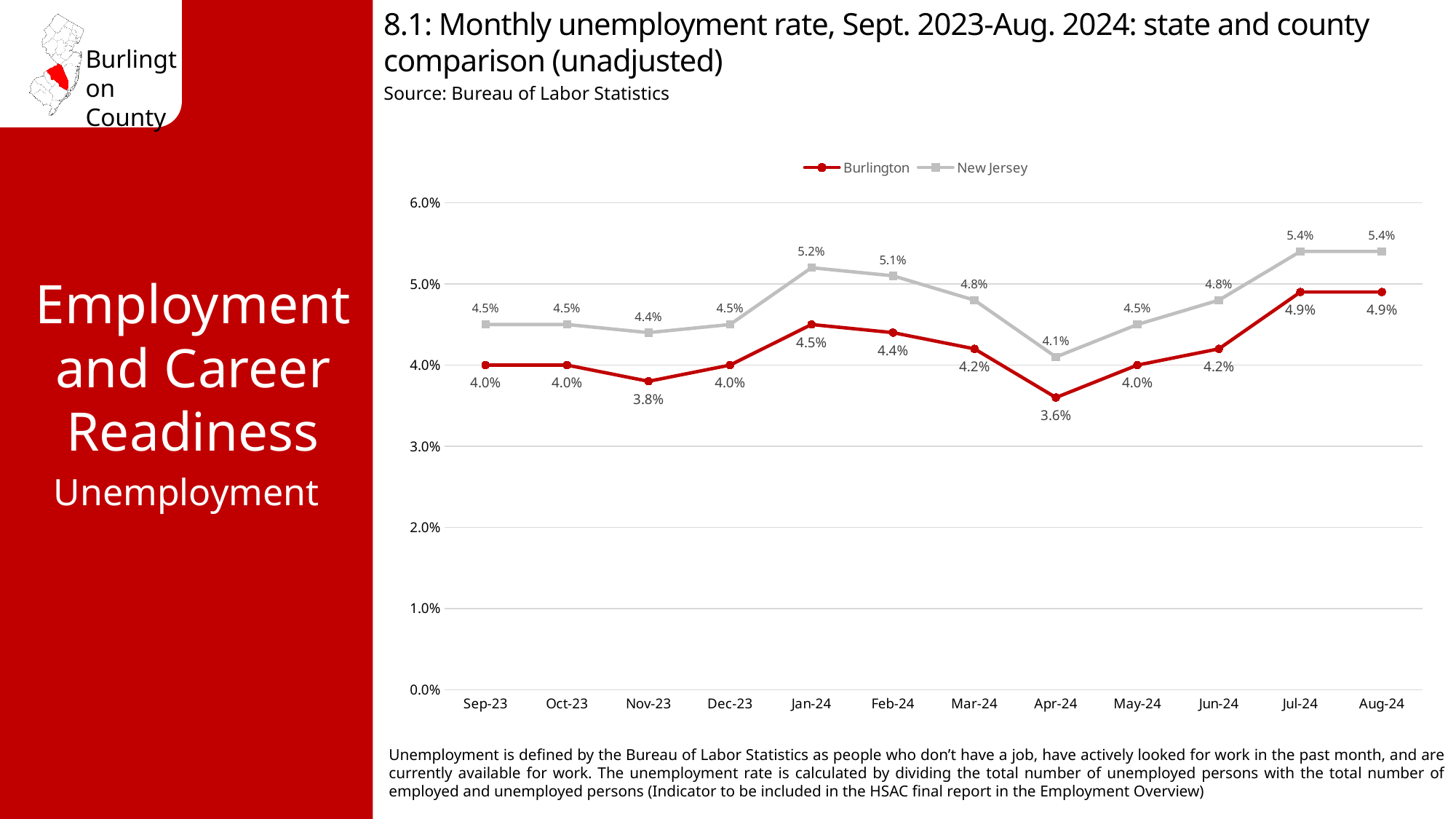
In which month was Burlington's unemployment rate lowest? Apr-24 In Aug-24, which had the higher unemployment rate, Burlington or New Jersey? New Jersey How many months are plotted on the x axis? 12 Did Burlington's unemployment rate rise or fall from Apr-24 to Jul-24? Rise What is the difference between New Jersey's and Burlington's unemployment rates in Jan-24? 0.7 percentage points How many series does the legend list? 2 What was New Jersey's unemployment rate in Jan-24? 5.2% What is the highest unemployment rate shown for New Jersey? 5.4% What kind of chart is shown on the slide? Line chart What was Burlington's unemployment rate in Apr-24? 3.6% What was Burlington's unemployment rate in Nov-23? 3.8% In which month was New Jersey's unemployment rate lowest? Apr-24